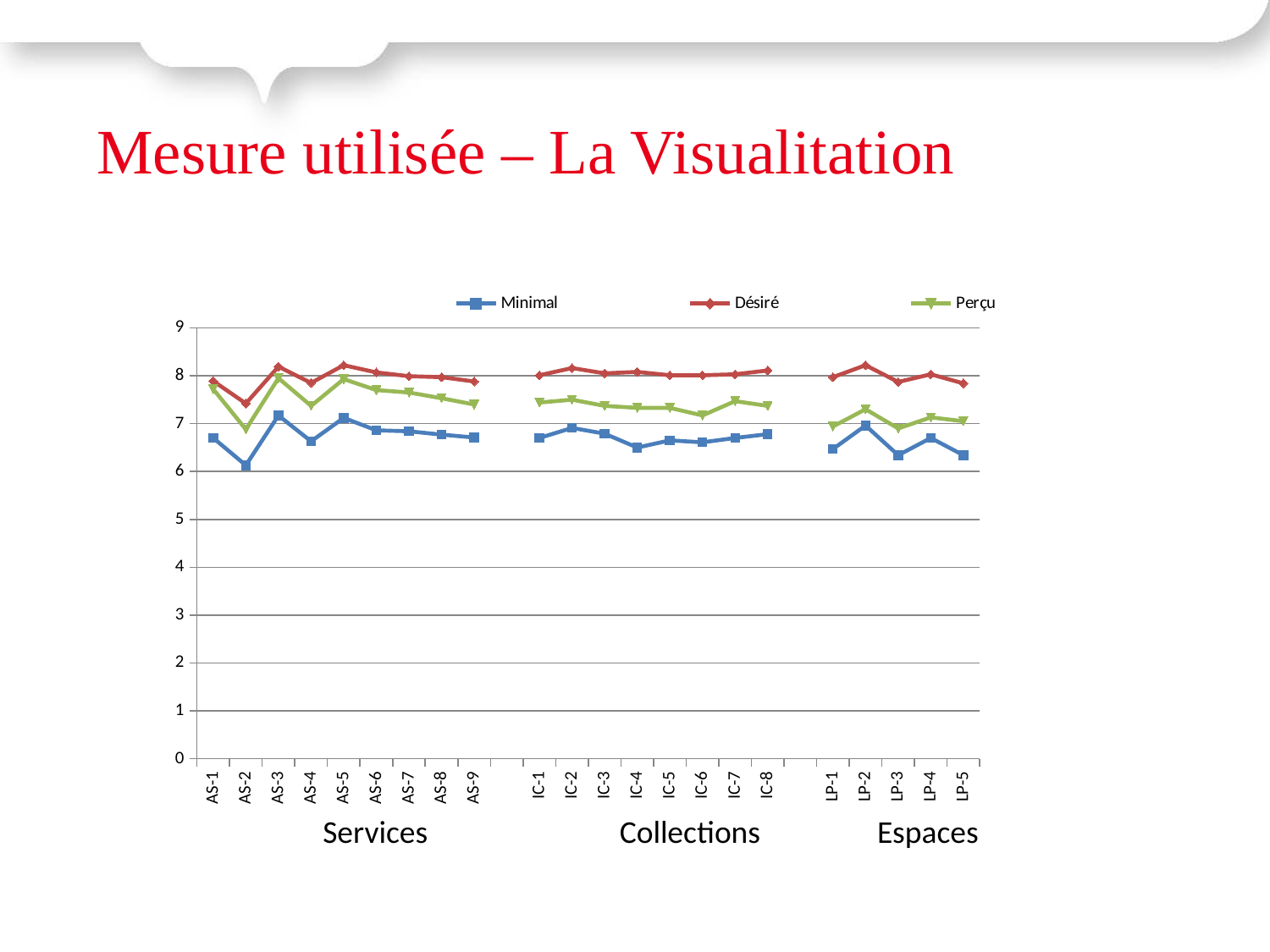
How many series does the legend list? 3 What are the three group labels shown below the x axis? Services, Collections, Espaces What kind of chart is shown on the slide? line chart Which category has the lowest Minimal value? AS-2 Is the Désiré value for AS-3 greater or less than 8? greater How many categories are plotted along the x axis? 22 Which category has the lowest Désiré value? AS-2 Is the Perçu value for IC-6 greater or less than 7? greater What are the names of the three series in the legend? Minimal, Désiré, Perçu Is the Minimal value for AS-2 greater or less than 7? less At IC-4, which series has the larger value, Désiré or Minimal? Désiré